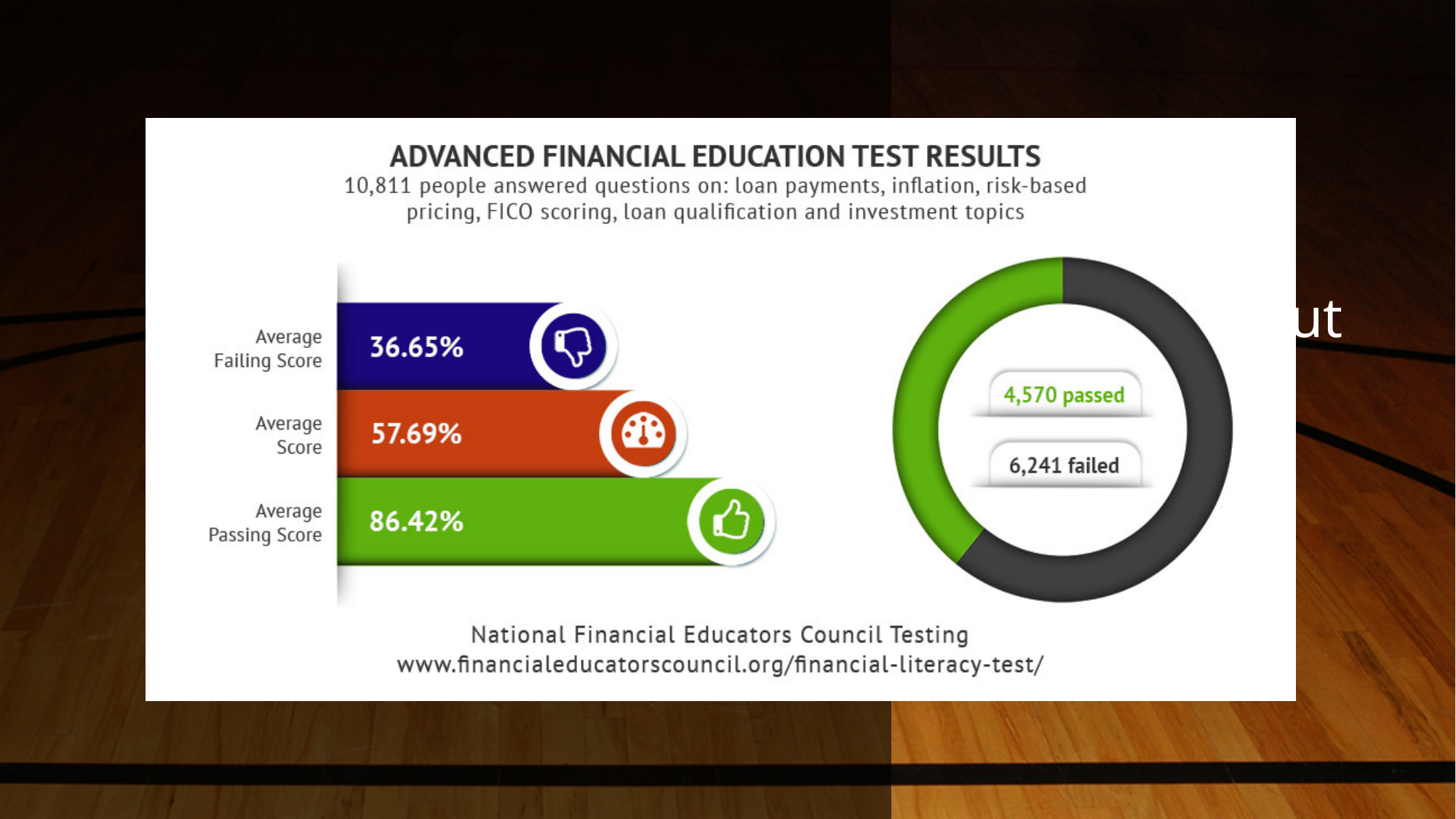
In the donut chart on the right, how many more people failed than passed? 1,671 What type of chart is shown on the left side of the slide? Bar chart In the donut chart on the right, which is larger, the number who passed or the number who failed? Failed In the bar chart on the left, how many bars are shown? 3 In the bar chart on the left, what is the Average Score? 57.69% In the bar chart on the left, which category has the highest value? Average Passing Score In the donut chart on the right, how many people failed? 6,241 In the bar chart on the left, which category has the lowest value? Average Failing Score In the bar chart on the left, what is the Average Failing Score? 36.65% In the bar chart on the left, what is the Average Passing Score? 86.42% In the bar chart on the left, what is the difference between the Average Passing Score and the Average Failing Score? 49.77 percentage points In the donut chart on the right, how many people passed? 4,570